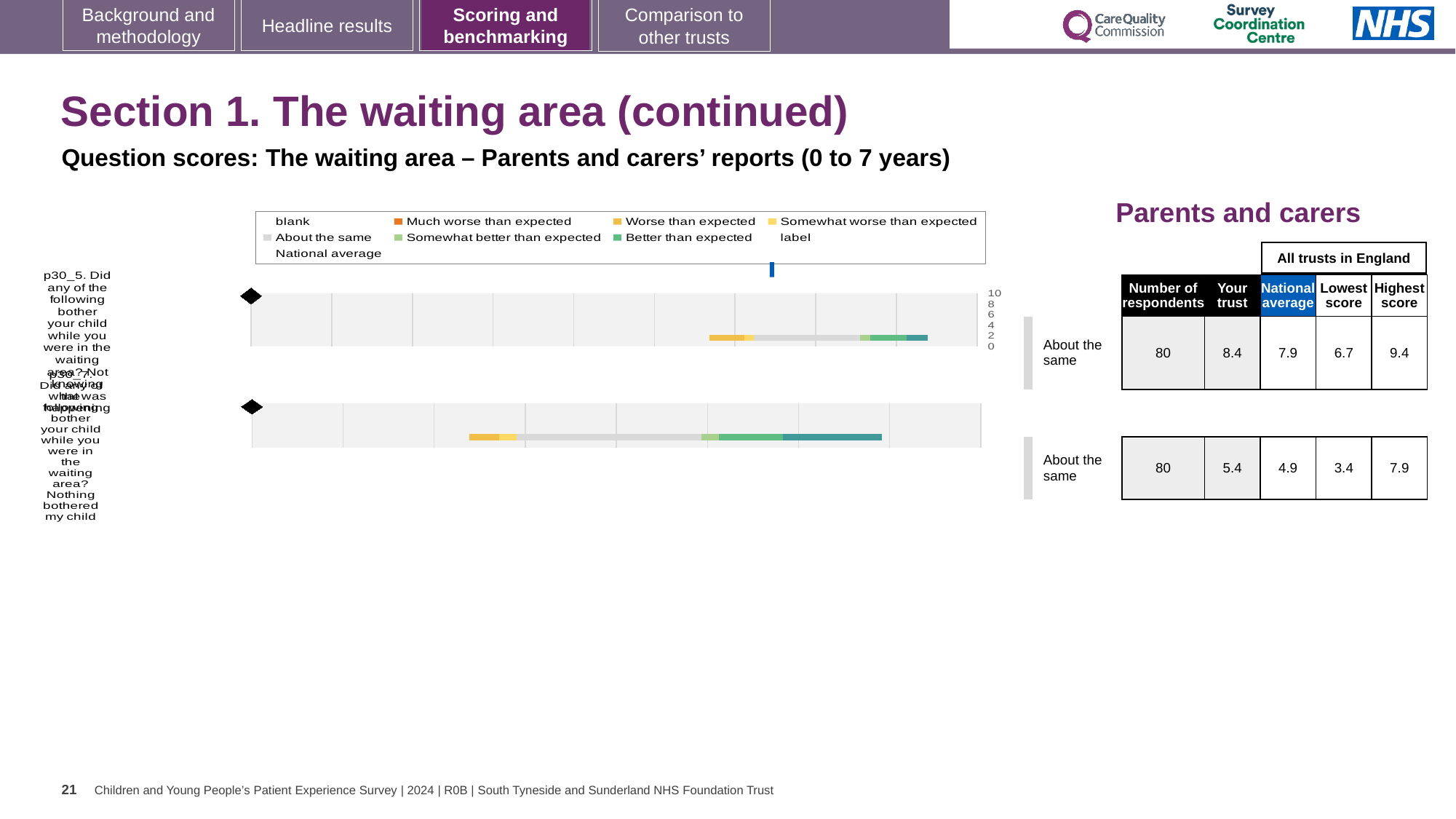
What kind of chart is used to show the question scores on this slide? bar chart Which of the two plotted questions has the higher 'Your trust' score? p30_5 (Not knowing what was happening) What benchmark category label is given to both plotted questions to the right of the chart? About the same What is the lowest score among all trusts in England for p30_5 (Not knowing what was happening)? 6.7 What is the highest score among all trusts in England for p30_7 (Nothing bothered my child)? 7.9 According to the table beside the chart, what is the national average for p30_7 (Nothing bothered my child)? 4.9 How many survey questions are plotted as rows in the chart? 2 For p30_5 (Not knowing what was happening), which is larger: the trust's score or the national average? Your trust How many entries does the chart legend list? 9 What is the highest value shown on the chart's score axis? 10 For p30_5 (Not knowing what was happening), what is the difference between the trust's score (8.4) and the national average (7.9)? 0.5 According to the table beside the chart, what is the 'Your trust' score for p30_5 (Not knowing what was happening)? 8.4